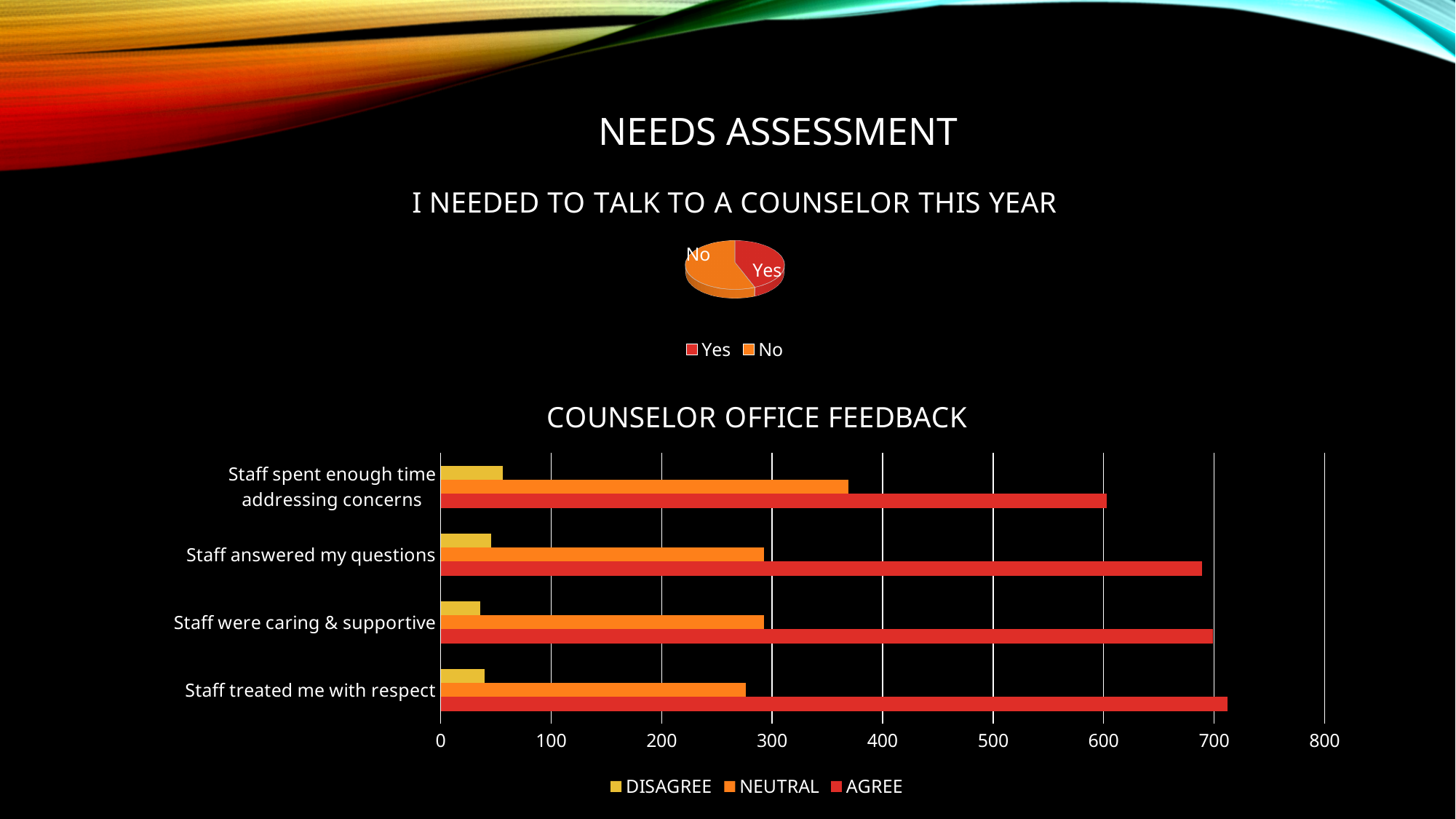
How many categories are shown on the 'Counselor Office Feedback' chart? 4 In the 'Counselor Office Feedback' chart, which category has the lowest AGREE value? Staff spent enough time addressing concerns How many series does the legend of the 'Counselor Office Feedback' chart list? 3 In the 'Counselor Office Feedback' chart, is the AGREE value for 'Staff treated me with respect' greater or less than 700? greater In the 'Counselor Office Feedback' chart, which category has the highest NEUTRAL value? Staff spent enough time addressing concerns What kind of chart is the 'I needed to talk to a counselor this year' chart? pie chart In the 'Counselor Office Feedback' chart, is the DISAGREE value for 'Staff answered my questions' greater or less than 100? less In the 'Counselor Office Feedback' chart, is the NEUTRAL value for 'Staff spent enough time addressing concerns' greater or less than 300? greater In the 'Counselor Office Feedback' chart, which is larger for 'Staff answered my questions': the AGREE value or the NEUTRAL value? AGREE What kind of chart is the 'Counselor Office Feedback' chart? bar chart What are the two legend entries of the 'I needed to talk to a counselor this year' pie chart? Yes and No